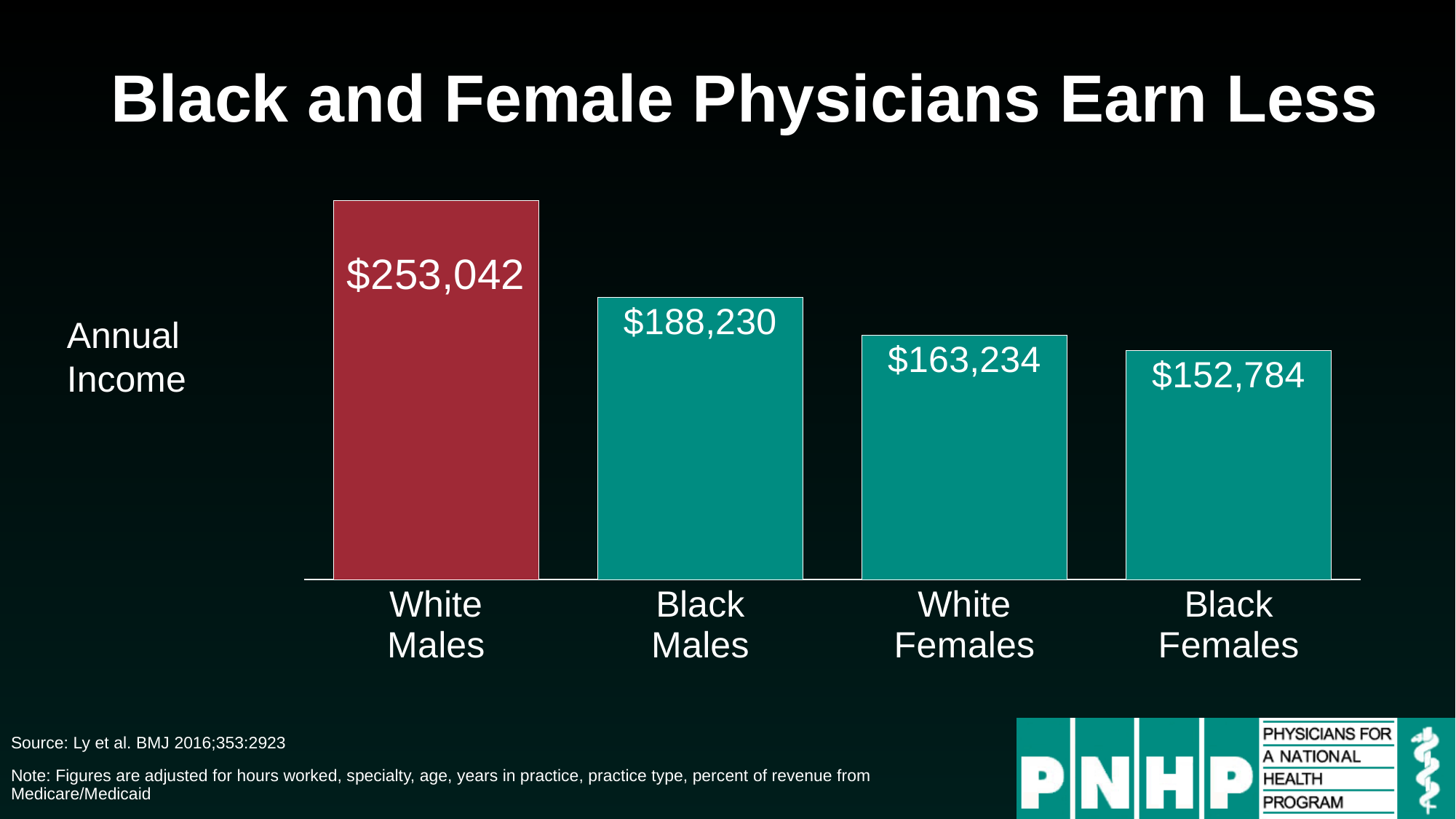
Which group earns more, Black Males or White Females? Black Males What is the difference in annual income between White Males and Black Females? $100,258 How many groups are shown on the chart? 4 What is the difference in annual income between White Males and Black Males? $64,812 Which group has the highest annual income on the chart? White Males What is the annual income shown for Black Females? $152,784 What kind of chart is shown on the slide? Bar chart What is the annual income shown for White Females? $163,234 Which group has the lowest annual income on the chart? Black Females Do the annual income values rise or fall from left to right across the chart? Fall Which bar is shown in a different colour (red) from the others? White Males What is the annual income shown for White Males? $253,042